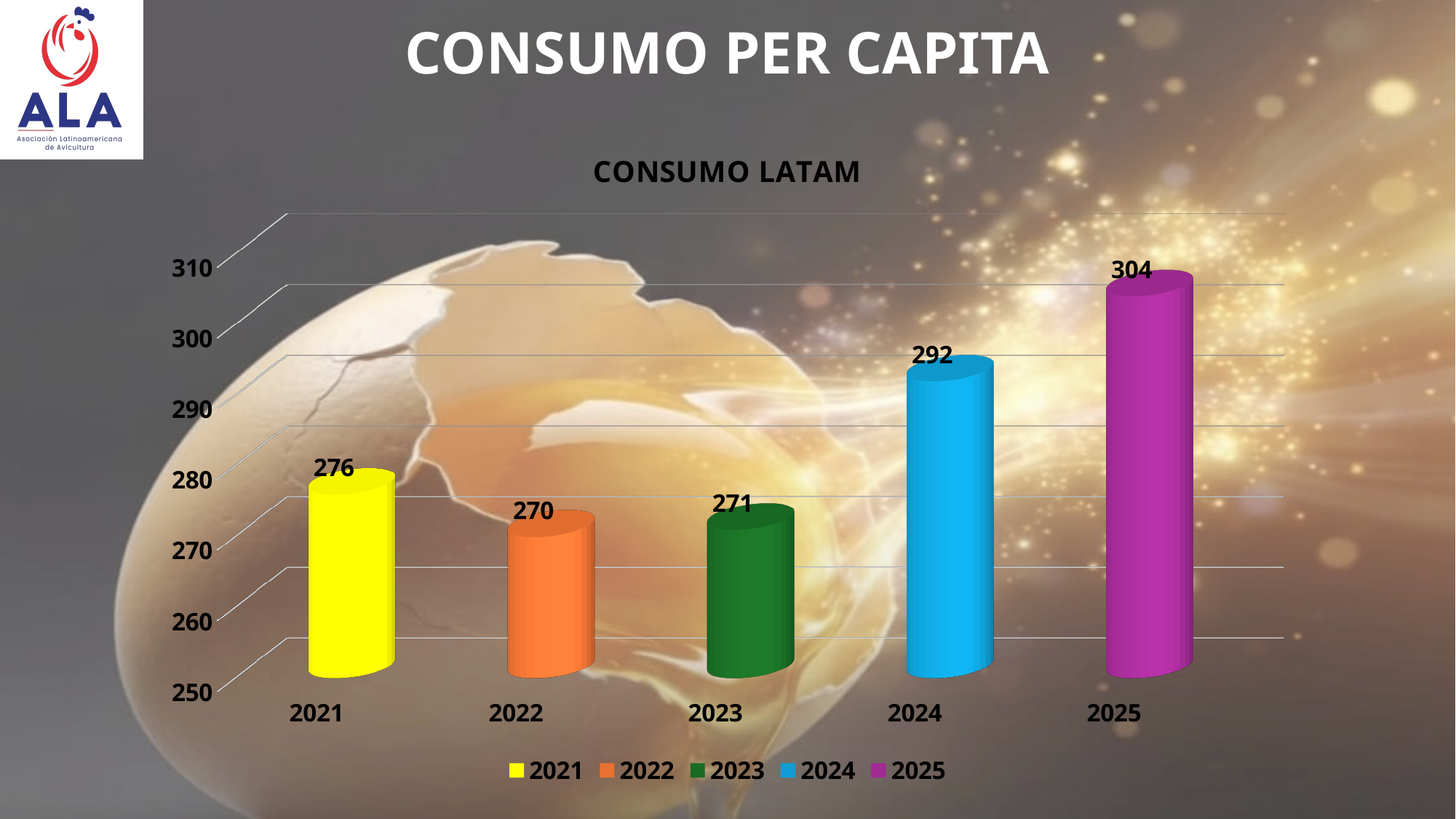
What is the difference between the values for 2021 and 2022? 6 Which year has the lowest value in the CONSUMO LATAM chart? 2022 Which year has the highest value in the CONSUMO LATAM chart? 2025 Is the value for 2024 greater or less than 290? greater What is the title of the chart on the slide? CONSUMO LATAM What is the difference between the values for 2025 and 2024? 12 What is the value for 2021 in the CONSUMO LATAM chart? 276 How many years are shown on the x axis of the chart? 5 What kind of chart is shown on the slide? bar chart What is the value for 2023 in the CONSUMO LATAM chart? 271 What is the value for 2025 in the CONSUMO LATAM chart? 304 Which is larger, the value for 2021 or the value for 2024? 2024